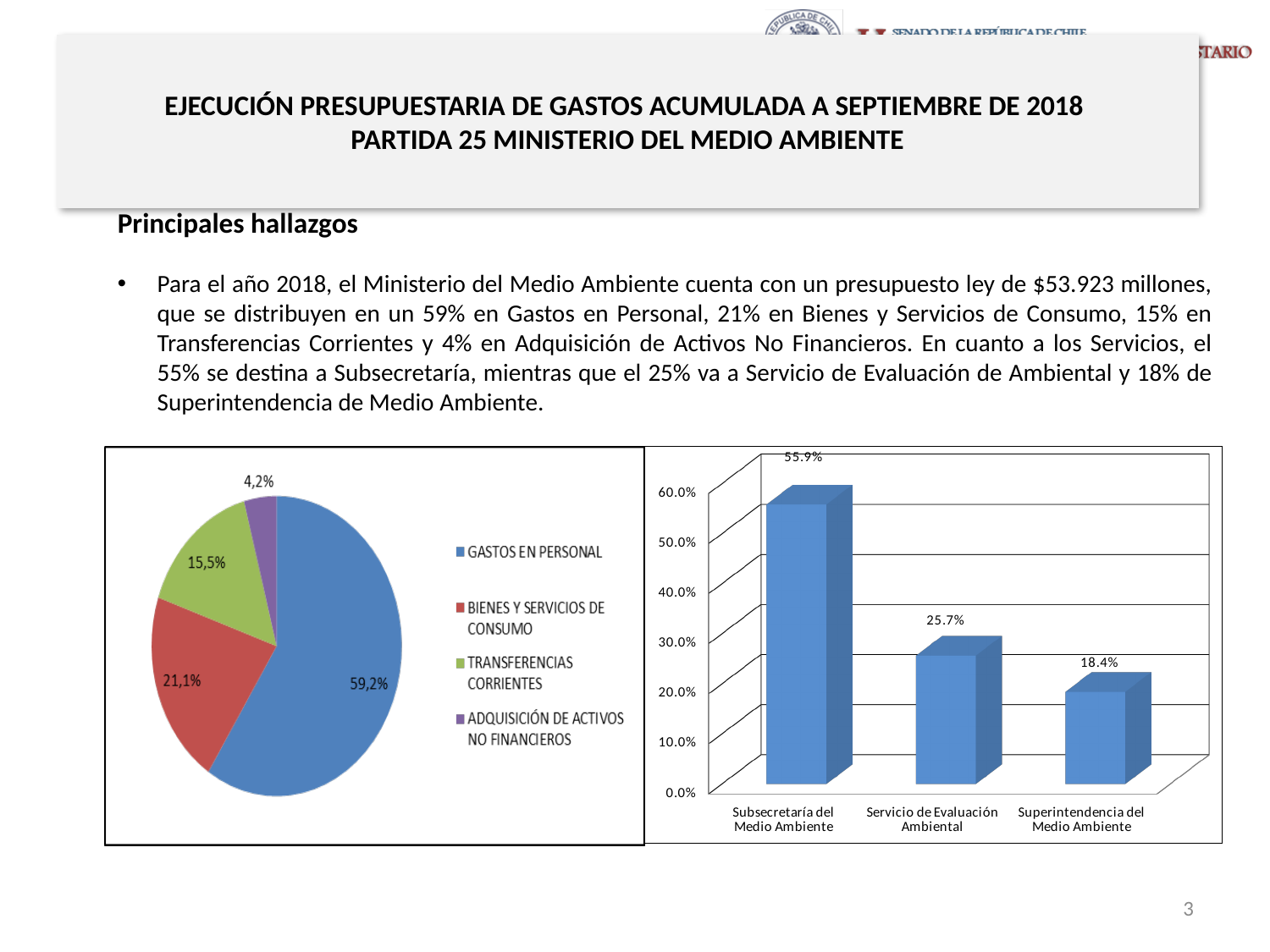
In the bar chart on the right, what is the value for Superintendencia del Medio Ambiente? 18.4% In the pie chart on the left, which category has the smallest slice? ADQUISICIÓN DE ACTIVOS NO FINANCIEROS In the bar chart on the right, do the values rise or fall from left to right? Fall How many categories does the legend of the pie chart on the left list? 4 In the pie chart on the left, which category has the largest slice? GASTOS EN PERSONAL In the pie chart on the left, what share does TRANSFERENCIAS CORRIENTES have? 15,5% In the pie chart on the left, what is the difference between the shares of BIENES Y SERVICIOS DE CONSUMO and TRANSFERENCIAS CORRIENTES? 5,6% In the bar chart on the right, what is the value for Servicio de Evaluación Ambiental? 25.7% What kind of chart is the chart on the right of the slide? Bar chart In the bar chart on the right, which category has the highest value? Subsecretaría del Medio Ambiente In the bar chart on the right, what is the difference between Subsecretaría del Medio Ambiente and Servicio de Evaluación Ambiental? 30.2% In the pie chart on the left, what share does GASTOS EN PERSONAL have? 59,2%